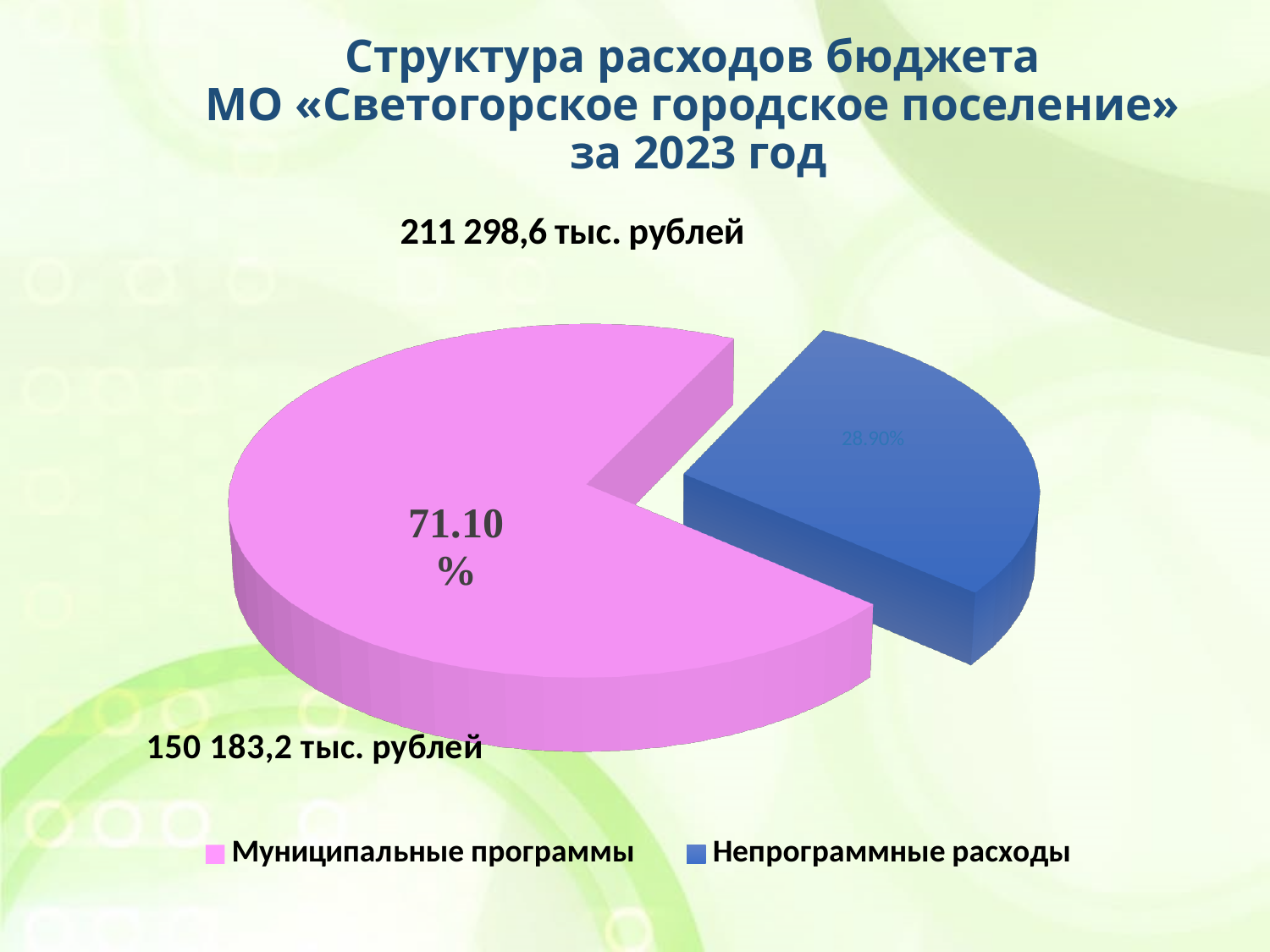
How many entries does the legend list? 2 Which slice of the pie is the largest? Муниципальные программы Which is larger: the share for Муниципальные программы or the share for Непрограммные расходы? Муниципальные программы How many slices does the pie chart have? 2 Which slice of the pie is the smallest? Непрограммные расходы What share of the pie does Муниципальные программы take? 71.10% What colour is the Непрограммные расходы slice? Blue What share of the pie does Непрограммные расходы take? 28.90% What total amount in thousand rubles is printed above the pie chart? 211 298,6 тыс. рублей What amount in thousand rubles is printed next to the Муниципальные программы slice? 150 183,2 тыс. рублей What kind of chart is shown on the slide? Pie chart What is the difference in percentage points between the Муниципальные программы and Непрограммные расходы slices? 42.20